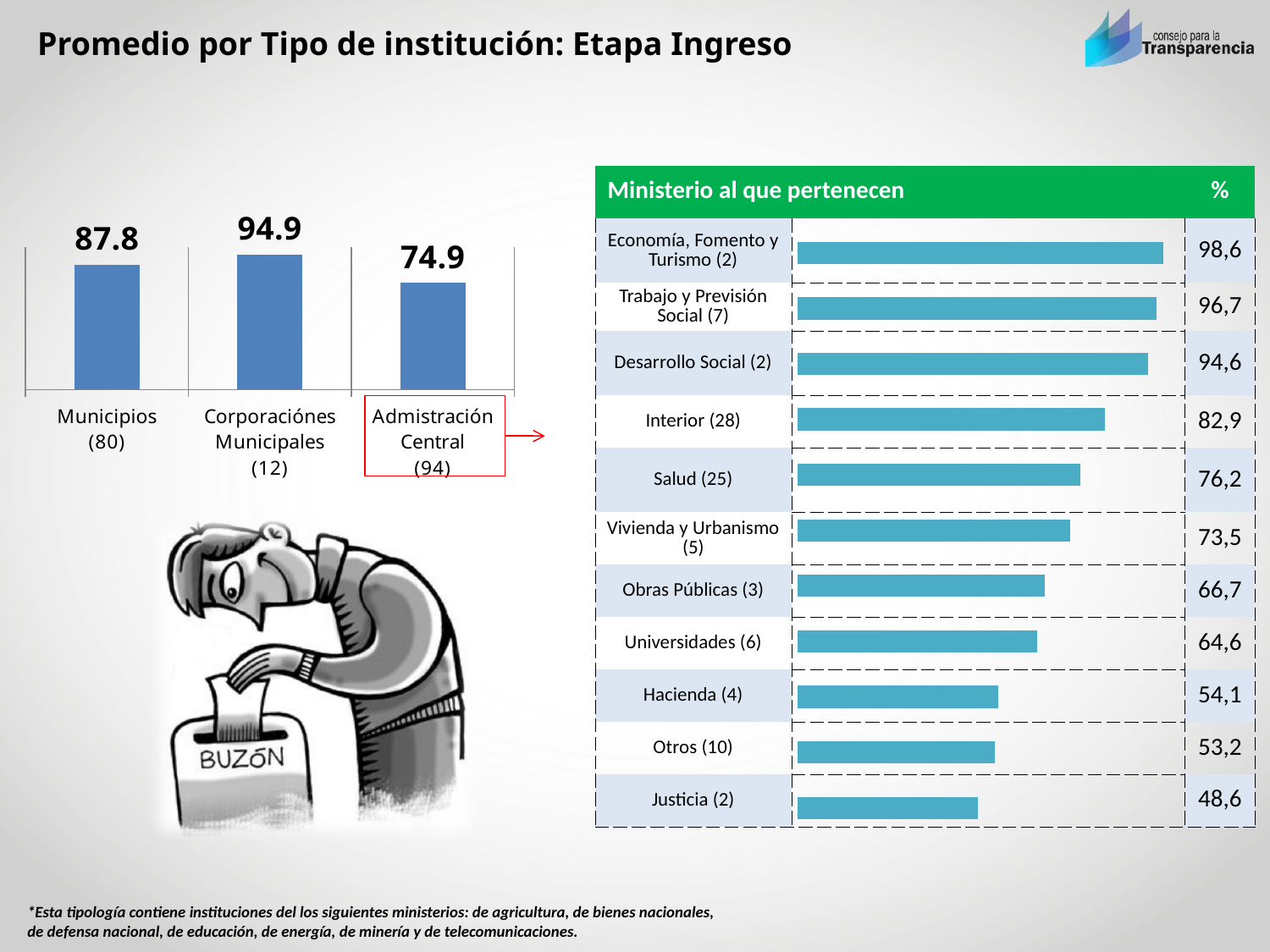
In the 'Ministerio al que pertenecen' chart on the right, how many ministries are listed? 11 In the 'Ministerio al que pertenecen' chart on the right, which ministry has the highest percentage? Economía, Fomento y Turismo (2) In the bar chart on the left, which category has the lowest value? Admistración Central (94) What kind of chart is the chart on the left? bar chart In the bar chart on the left, what is the difference between the values for Corporaciónes Municipales (12) and Admistración Central (94)? 20 In the bar chart on the left, what is the value for Municipios (80)? 87.8 In the 'Ministerio al que pertenecen' chart on the right, what is the percentage for Interior (28)? 82,9 In the bar chart on the left, which category has the highest value? Corporaciónes Municipales (12) In the 'Ministerio al que pertenecen' chart on the right, which is larger: the value for Salud (25) or the value for Vivienda y Urbanismo (5)? Salud (25) In the bar chart on the left, how many categories are shown? 3 In the bar chart on the left, what is the value for Corporaciónes Municipales (12)? 94.9 In the 'Ministerio al que pertenecen' chart on the right, which ministry has the lowest percentage? Justicia (2)